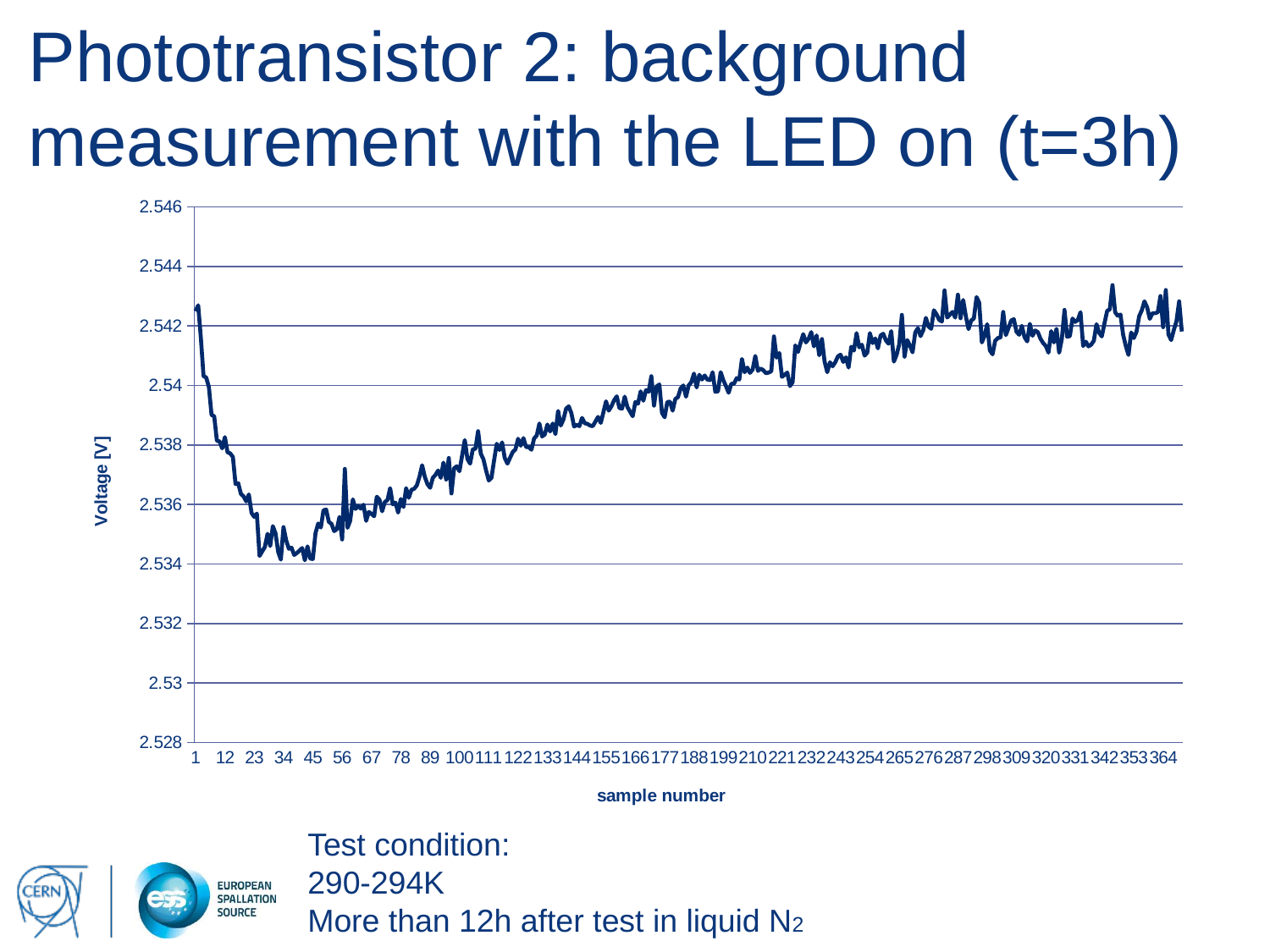
Does the voltage rise or fall between sample number 1 and sample number 23? fall Is the voltage at sample number 45 greater or less than 2.536? less Is the voltage at sample number 199 greater or less than 2.538? greater What is the label of the horizontal axis of the chart? sample number What kind of chart is shown on the slide? line chart What is the label of the vertical axis of the chart? Voltage [V] Is the voltage at sample number 364 greater or less than 2.54? greater Which is larger, the voltage at sample number 45 or the voltage at sample number 364? sample number 364 Does the voltage generally rise or fall between sample number 45 and sample number 364? rise